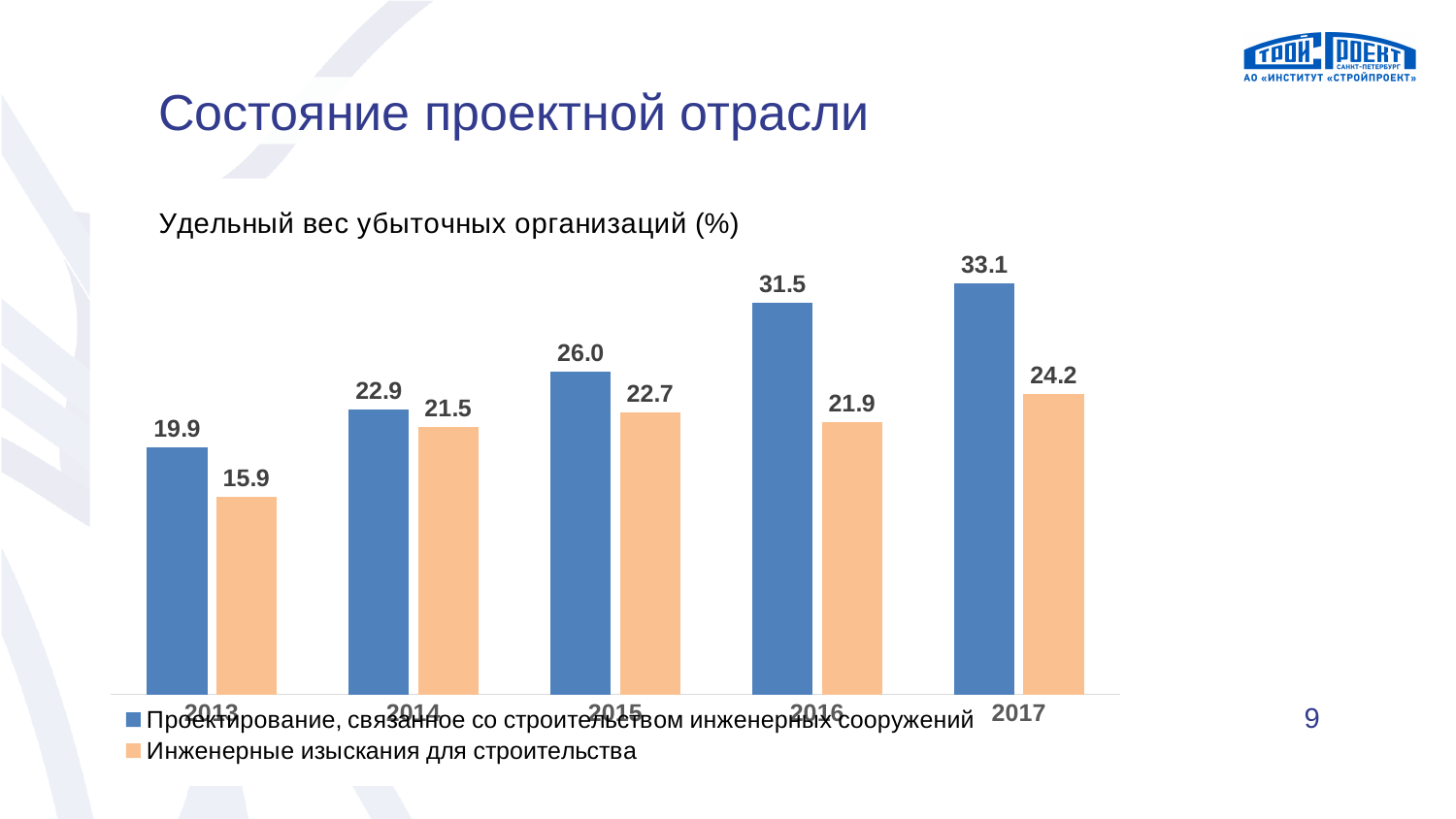
What is the value for 'Проектирование, связанное со строительством инженерных сооружений' in 2017? 33.1 How many series does the legend list? 2 What is the difference between the two series' values in 2017? 8.9 What is the value for 'Инженерные изыскания для строительства' in 2016? 21.9 In which year is the value for 'Проектирование, связанное со строительством инженерных сооружений' the lowest? 2013 Which series has the larger value in 2015? Проектирование, связанное со строительством инженерных сооружений What is the title of the chart? Удельный вес убыточных организаций (%) What is the value for 'Инженерные изыскания для строительства' in 2013? 15.9 What kind of chart is shown on the slide? Bar chart Does the value for 'Проектирование, связанное со строительством инженерных сооружений' rise or fall from 2013 to 2017? Rise In which year is the value for 'Инженерные изыскания для строительства' the highest? 2017 How many years are shown on the x axis? 5